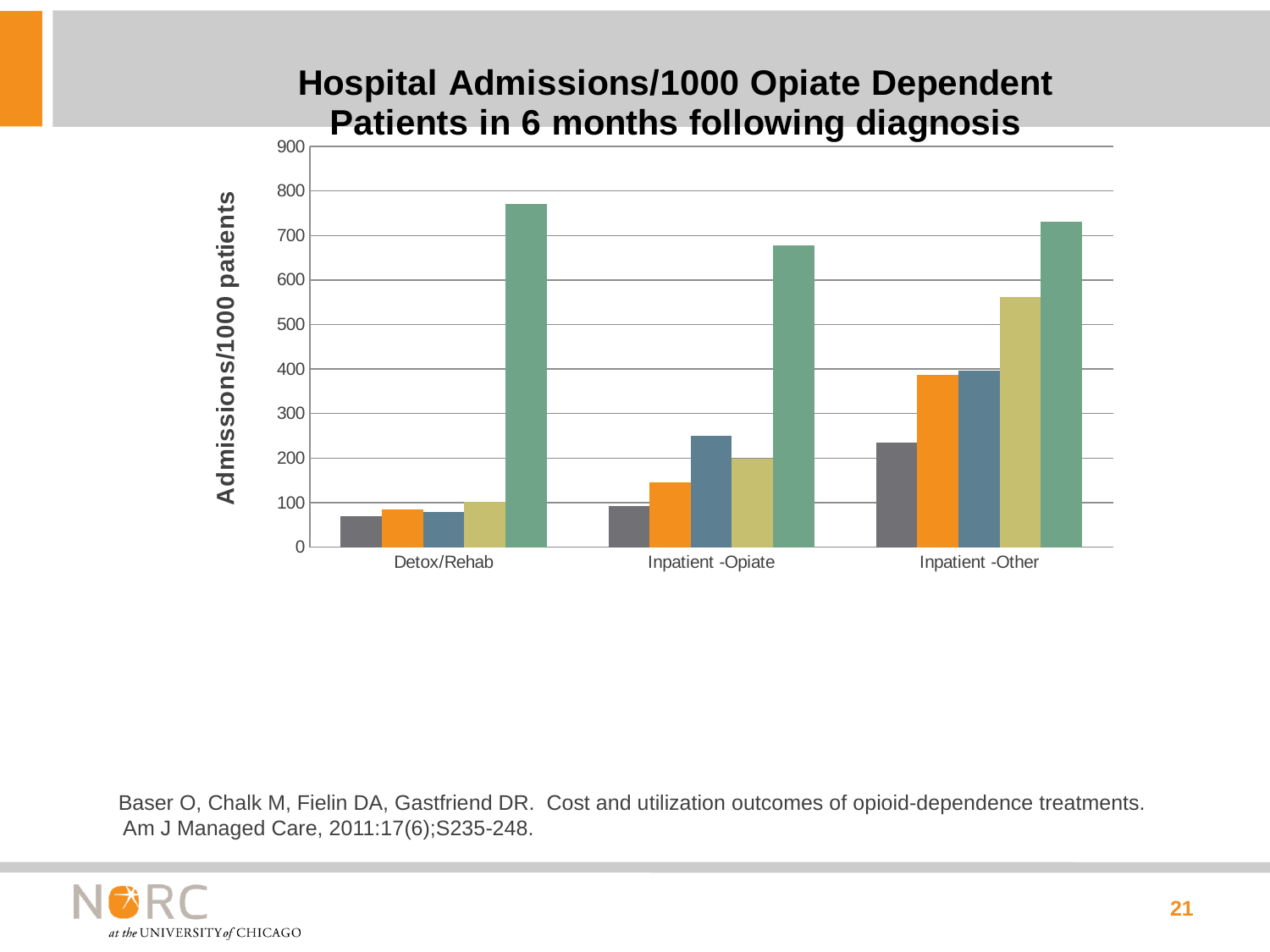
Is the value of the tan bar for Inpatient -Other greater or less than 500? greater Is the value of the green bar for Inpatient -Opiate greater or less than 700? less How many bars are plotted for each category in the chart? 5 What is the label on the vertical axis of the chart? Admissions/1000 patients Which category has the tallest dark gray bar? Inpatient -Other Is the value of the green bar for Detox/Rehab greater or less than 700? greater What kind of chart is shown on the slide? bar chart How many categories are shown on the x axis of the chart? 3 For Inpatient -Other, which is larger: the orange bar or the tan bar? the tan bar What is the title of the chart? Hospital Admissions/1000 Opiate Dependent Patients in 6 months following diagnosis